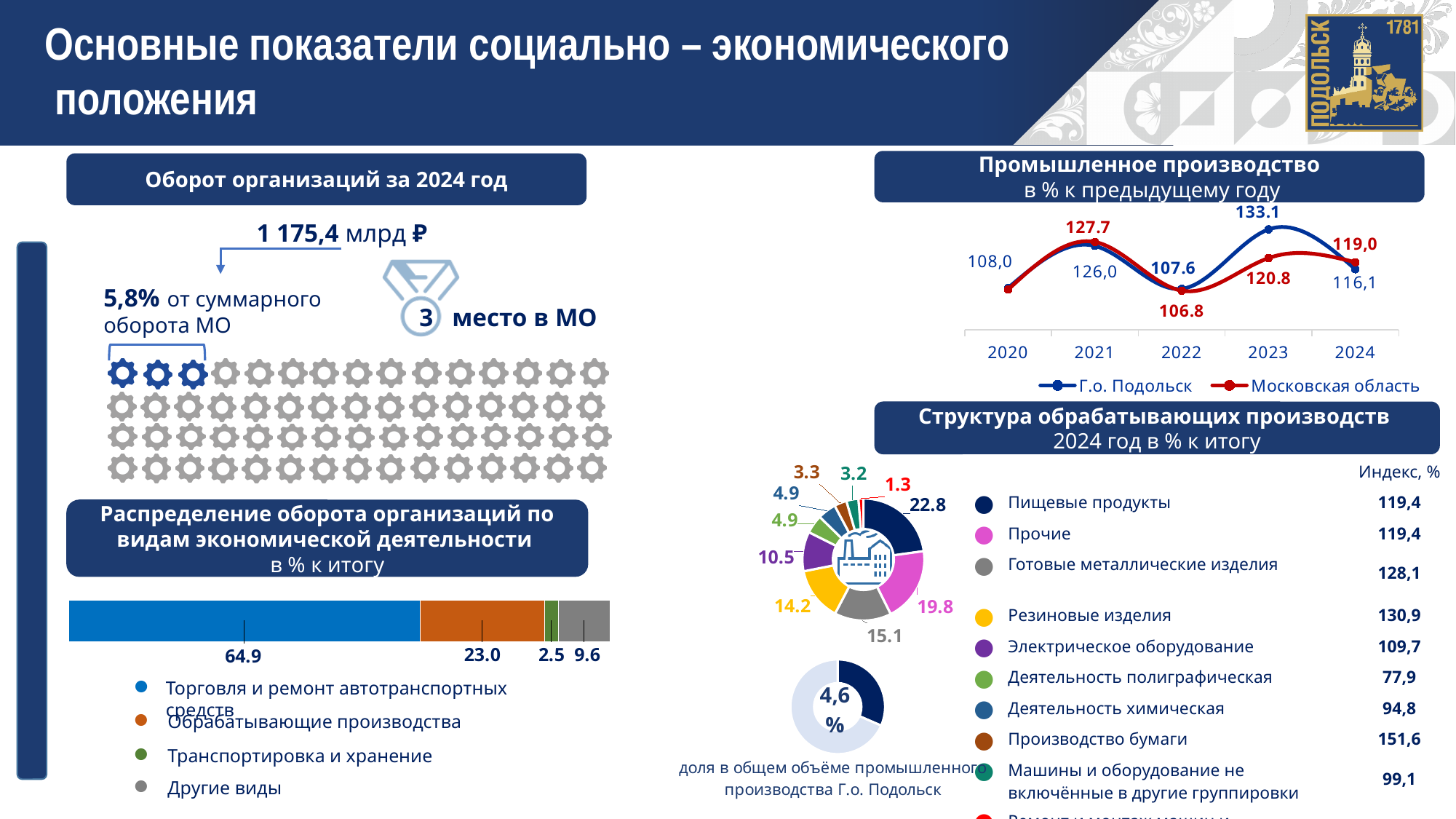
In the 'Распределение оборота организаций по видам экономической деятельности' bar chart, what is the value for Обрабатывающие производства? 23.0 In the 'Распределение оборота организаций по видам экономической деятельности' bar chart, which category has the smallest value? Транспортировка и хранение In the 'Промышленное производство' line chart, what is the value for Г.о. Подольск in 2023? 133.1 In the 'Промышленное производство' line chart, what is the value for Московская область in 2021? 127.7 In the 'Структура обрабатывающих производств' donut chart, what is the share for Резиновые изделия? 14.2 In the 'Промышленное производство' line chart, in which year is the Г.о. Подольск value highest? 2023 In the 'Промышленное производство' line chart, which series has the larger value in 2024? Московская область What type of chart is 'Промышленное производство в % к предыдущему году'? Line chart How many series does the legend of the 'Промышленное производство' line chart list? 2 In the 'Структура обрабатывающих производств' donut chart, which category has the largest share? Пищевые продукты In the 'Промышленное производство' line chart, what is the difference between Г.о. Подольск and Московская область in 2023? 12.3 In the 'Промышленное производство' line chart, in which year is the Московская область value lowest? 2022